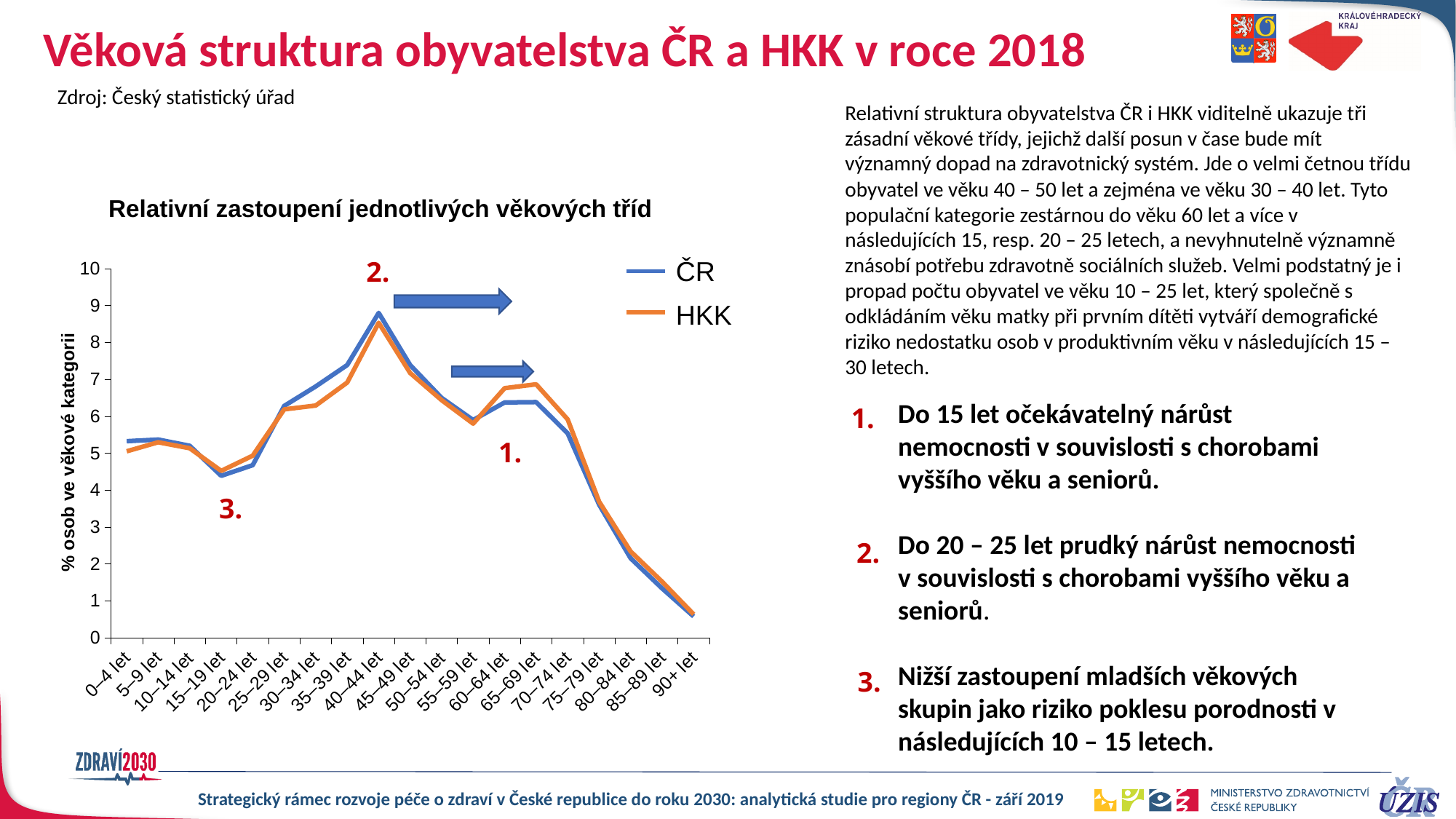
What is the title of the chart? Relativní zastoupení jednotlivých věkových tříd Is the value for ČR in the 40–44 let category greater or less than 8? greater Which two series are shown in the chart legend? ČR and HKK In the 65–69 let category, which series has the larger value, ČR or HKK? HKK How many series does the legend of the chart list? 2 Is the value for HKK in the 90+ let category greater or less than 1? less In which age category does the ČR series reach its highest value? 40–44 let Do the values of the ČR series rise or fall from the 40–44 let category to the 90+ let category? fall What kind of chart is shown on the slide? line chart In which age category does the HKK series reach its lowest value? 90+ let How many age categories are plotted along the x axis of the chart? 19 Is the value for ČR in the 15–19 let category greater or less than 5? less